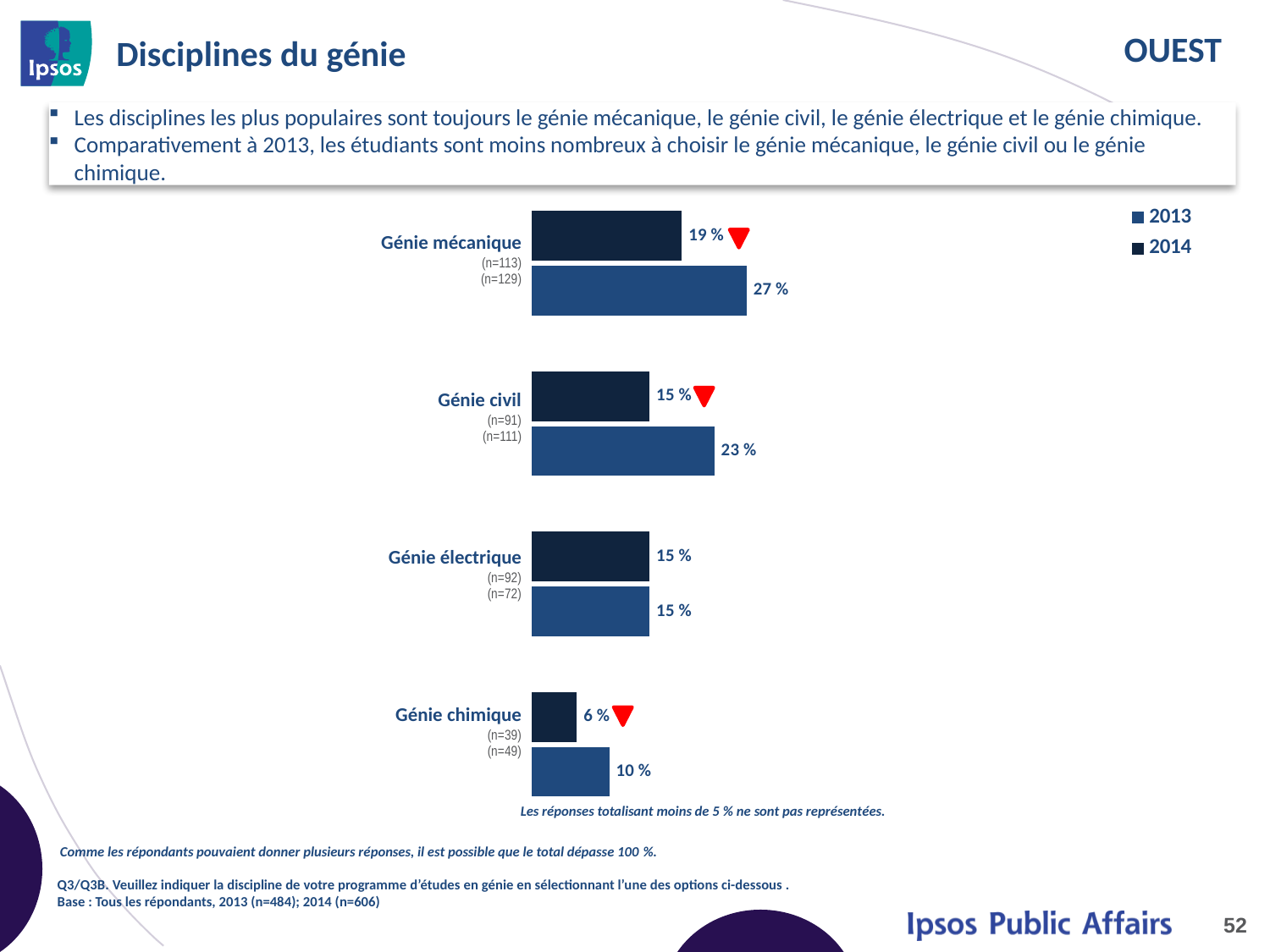
Which is larger: the lower bar for Génie civil or the lower bar for Génie électrique? Génie civil How many engineering disciplines are shown in the chart? 4 Which discipline has the lowest value in the chart? Génie chimique What value is shown on the lower bar for Génie chimique? 10 % What kind of chart is shown on the slide? Bar chart What are the two entries in the chart legend? 2013 and 2014 What is the difference between the two bars for Génie civil (23 % and 15 %)? 8 % What value is shown on the upper bar for Génie mécanique? 19 % What value is shown for both bars of Génie électrique? 15 % What is the difference between the two bars for Génie mécanique (27 % and 19 %)? 8 % How many series does the legend list? 2 Which discipline has the highest value in the chart? Génie mécanique